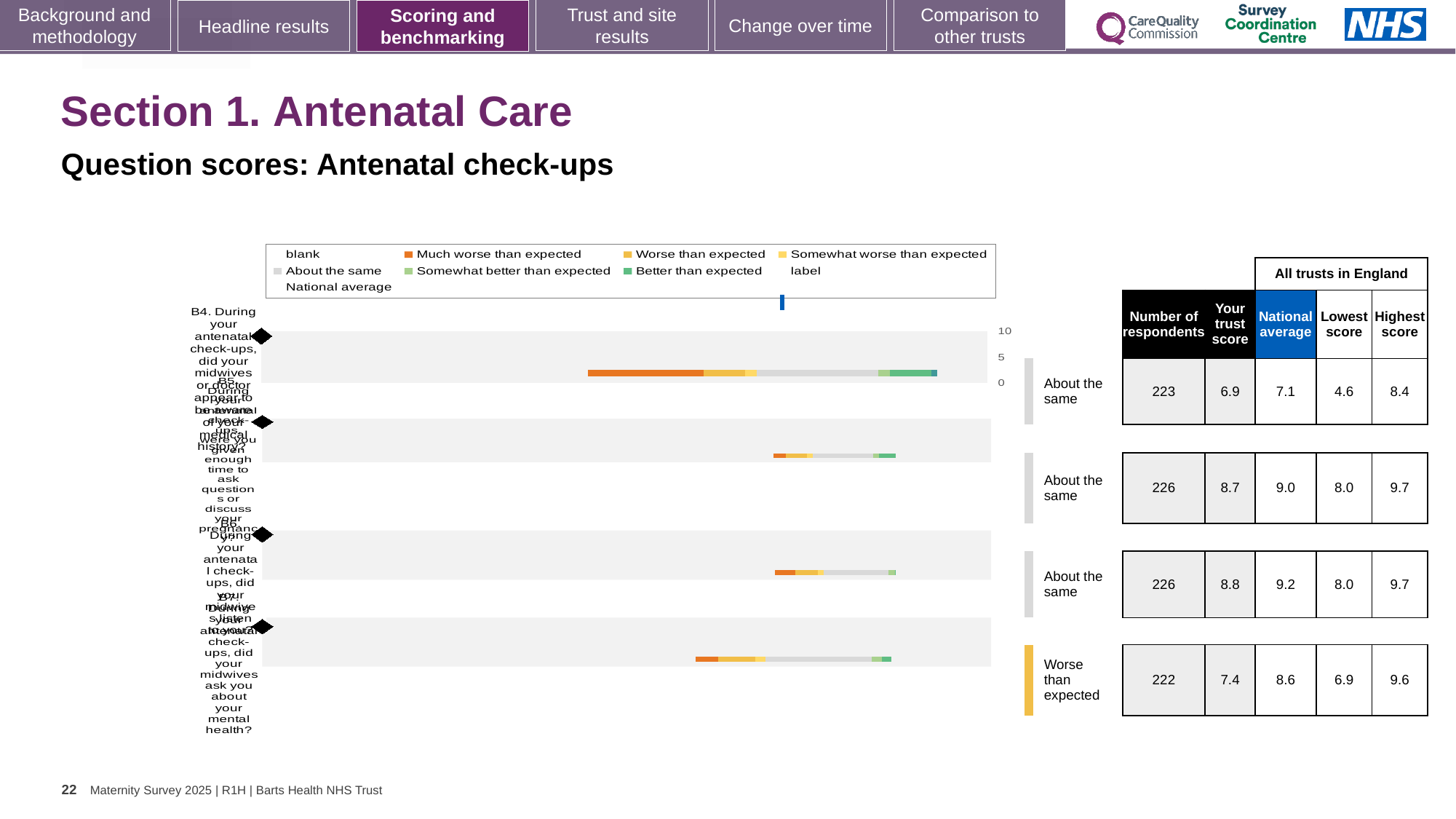
What kind of chart is shown on the slide? bar chart How many of the four questions are rated "About the same"? 3 What colour does the legend use for "Much worse than expected"? orange What is the highest tick value shown on the chart's score axis? 10 What benchmark rating is given to the fourth (bottom) question in the chart? Worse than expected How many question bars are plotted in the chart? 4 In the table, what is the number of respondents for the first question (B4, awareness of medical history)? 223 In the table, what is the national average for the first question (B4, awareness of medical history)? 7.1 For the first question (B4), which is larger: the trust score or the national average? National average In the table, what is the trust score for the first question (B4, awareness of medical history)? 6.9 Which row of the table has the highest "Your trust score"? The third row (8.8) For the first question (B4), what is the difference between the highest score and the lowest score in the table? 3.8